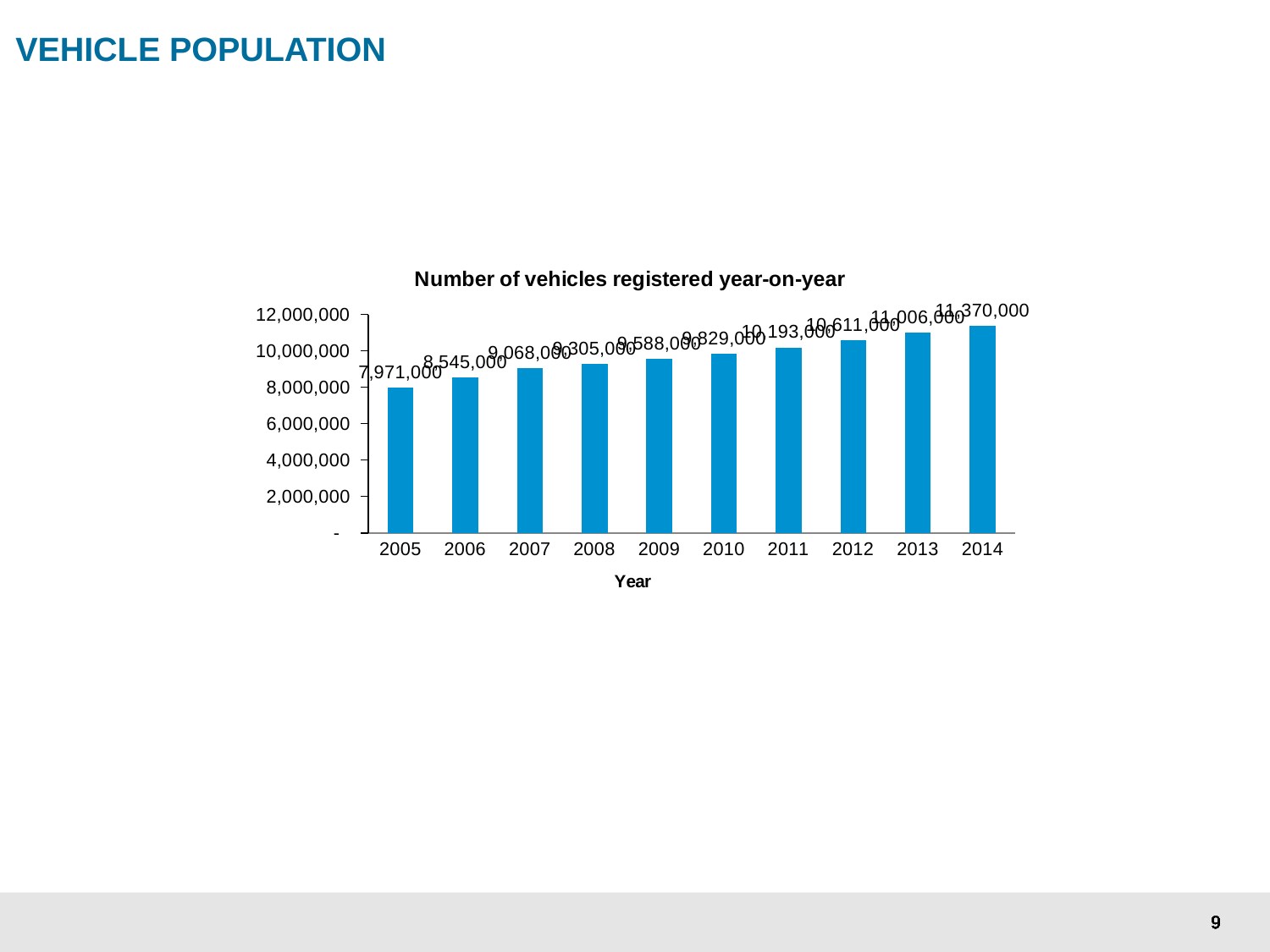
What is the number of vehicles registered in 2005? 7,971,000 Which year has more vehicles registered, 2008 or 2012? 2012 What is the title of the chart? Number of vehicles registered year-on-year Is the value for 2011 greater or less than 10,000,000? greater What type of chart is shown on the slide? bar chart How many years are plotted on the chart? 10 Which year has the highest number of vehicles registered? 2014 What is the difference between the number of vehicles registered in 2014 and in 2005? 3,399,000 What is the number of vehicles registered in 2014? 11,370,000 Do the values rise or fall from 2005 to 2014? rise What is the number of vehicles registered in 2006? 8,545,000 Which year has the lowest number of vehicles registered? 2005